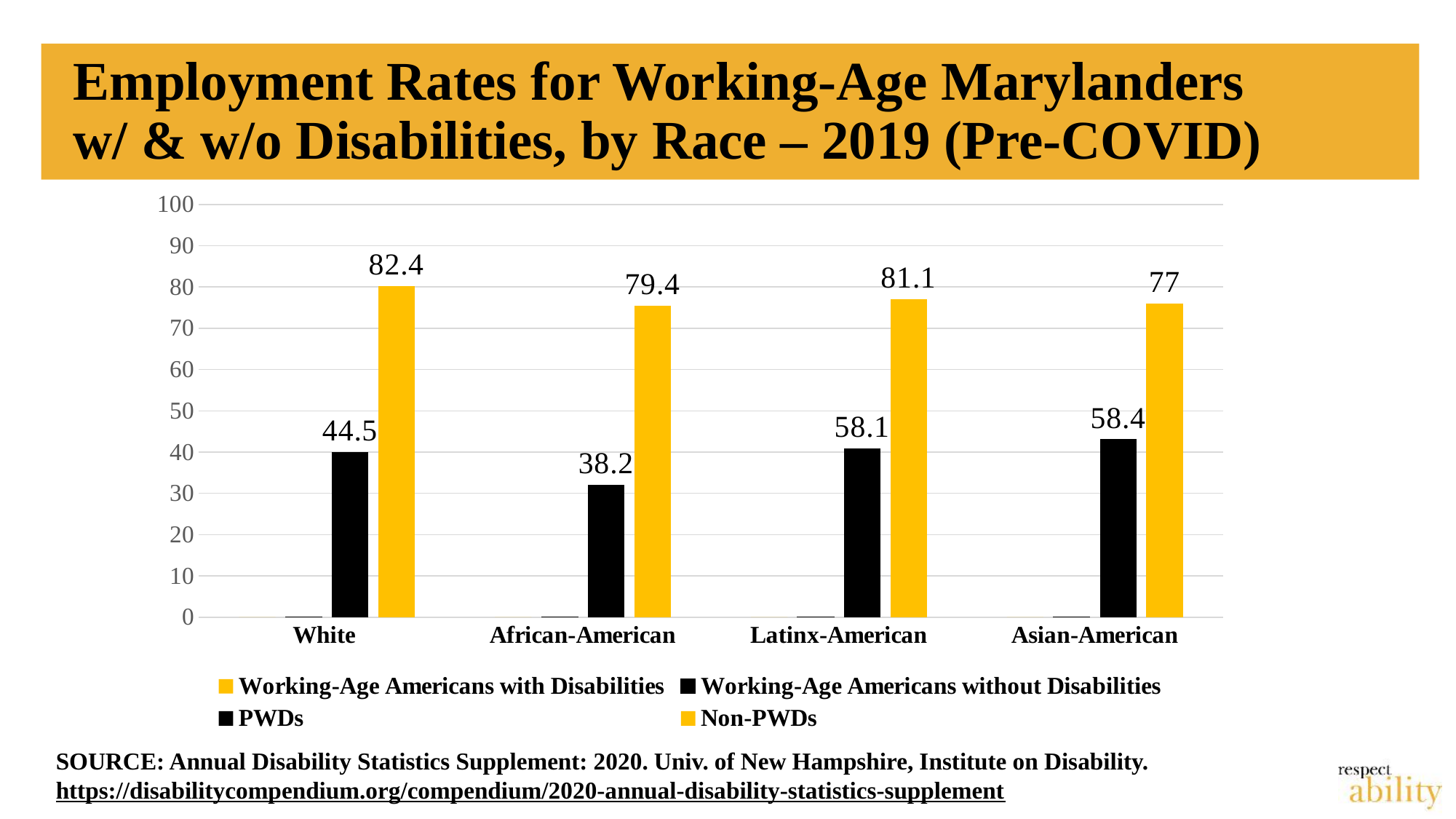
Which is larger: the PWDs value for White or the PWDs value for African-American? White What is the Non-PWDs (yellow bar) value for African-American? 79.4 How many race categories are shown on the x axis? 4 How many series does the legend list? 4 What is the Non-PWDs (yellow bar) value for Asian-American? 77 What is the difference between the Non-PWDs and PWDs values for White? 37.9 Which race category has the lowest PWDs (black bar) value? African-American What is the difference between the Non-PWDs and PWDs values for Asian-American? 18.6 What is the PWDs (black bar) value for Latinx-American? 58.1 What is the PWDs (black bar) value for White? 44.5 What kind of chart is shown on the slide? Bar chart